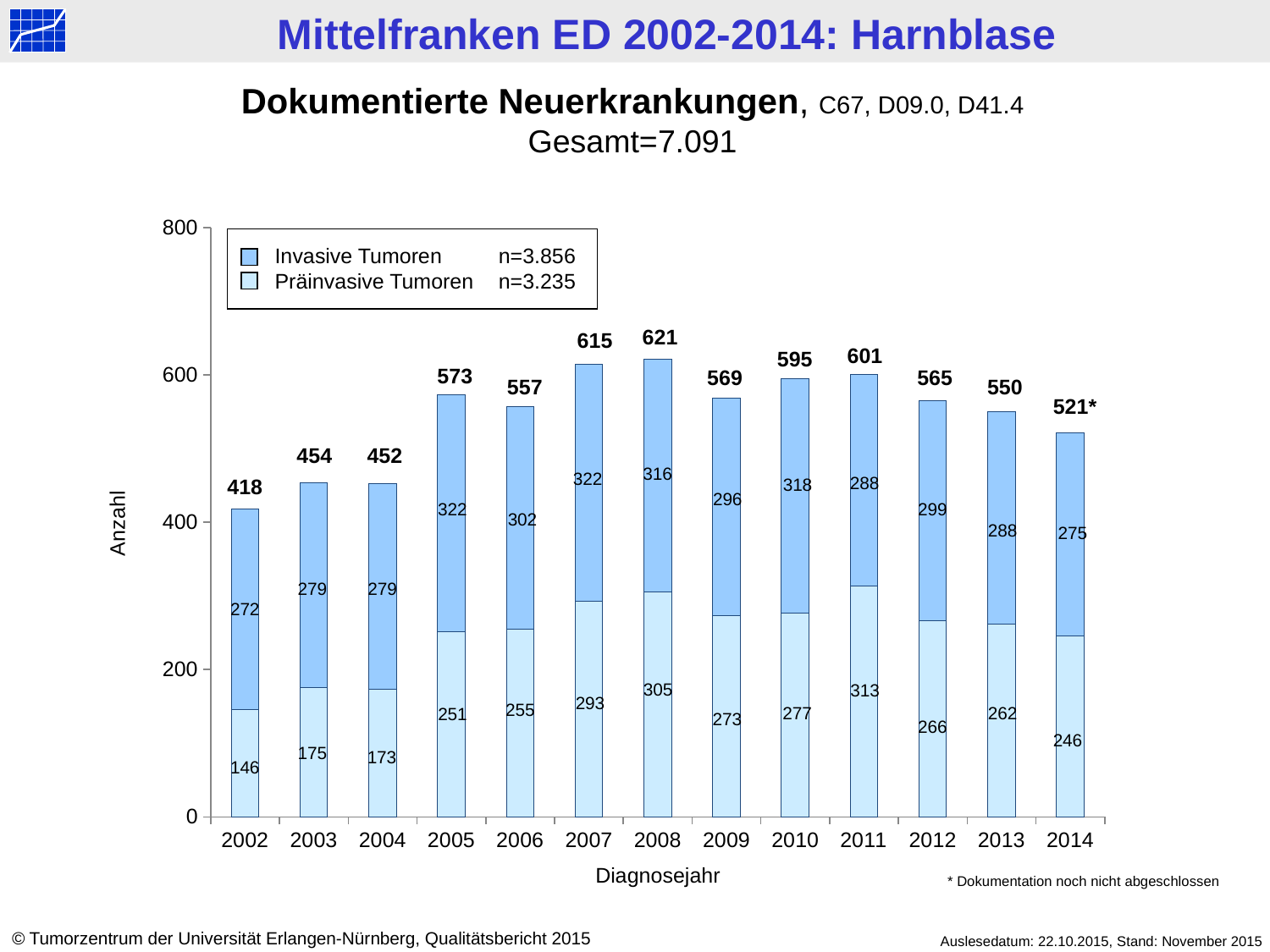
How many years are shown on the x axis? 13 What is the number of Invasive Tumoren in 2007? 322 What is the total number of documented new cases in 2008? 621 Which year has the lowest total number of cases? 2002 What is the number of Präinvasive Tumoren in 2011? 313 Which year has the highest number of Präinvasive Tumoren? 2011 Do the total values rise or fall from 2011 to 2014? Fall What kind of chart is shown? Stacked bar chart In 2011, which is larger: Invasive Tumoren or Präinvasive Tumoren? Präinvasive Tumoren How many series does the legend list? 2 What is the difference between Invasive Tumoren and Präinvasive Tumoren in 2005? 71 Which year has the highest total number of cases? 2008